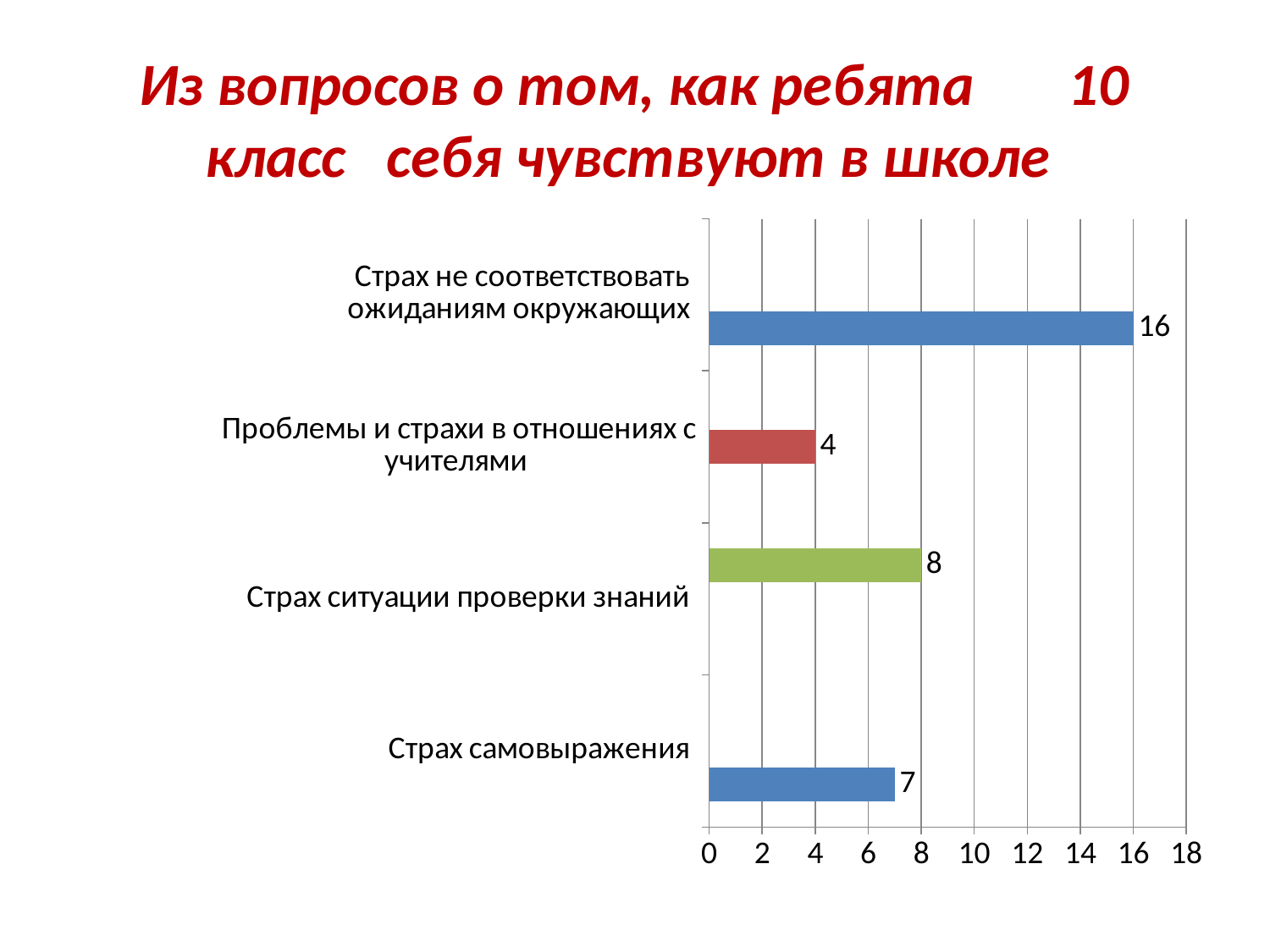
What is the value for "Страх самовыражения"? 7 What kind of chart is shown on the slide? bar chart Which category has the highest value? Страх не соответствовать ожиданиям окружающих What is the value for "Страх не соответствовать ожиданиям окружающих"? 16 What is the difference between the values for "Страх не соответствовать ожиданиям окружающих" and "Страх ситуации проверки знаний"? 8 Is the value for "Страх не соответствовать ожиданиям окружающих" greater or less than 10? greater What is the value for "Страх ситуации проверки знаний"? 8 How many categories are shown in the chart? 4 What is the value for "Проблемы и страхи в отношениях с учителями"? 4 Which is larger: the value for "Страх ситуации проверки знаний" or the value for "Страх самовыражения"? Страх ситуации проверки знаний What is the maximum value shown on the horizontal axis? 18 Which category has the lowest value? Проблемы и страхи в отношениях с учителями